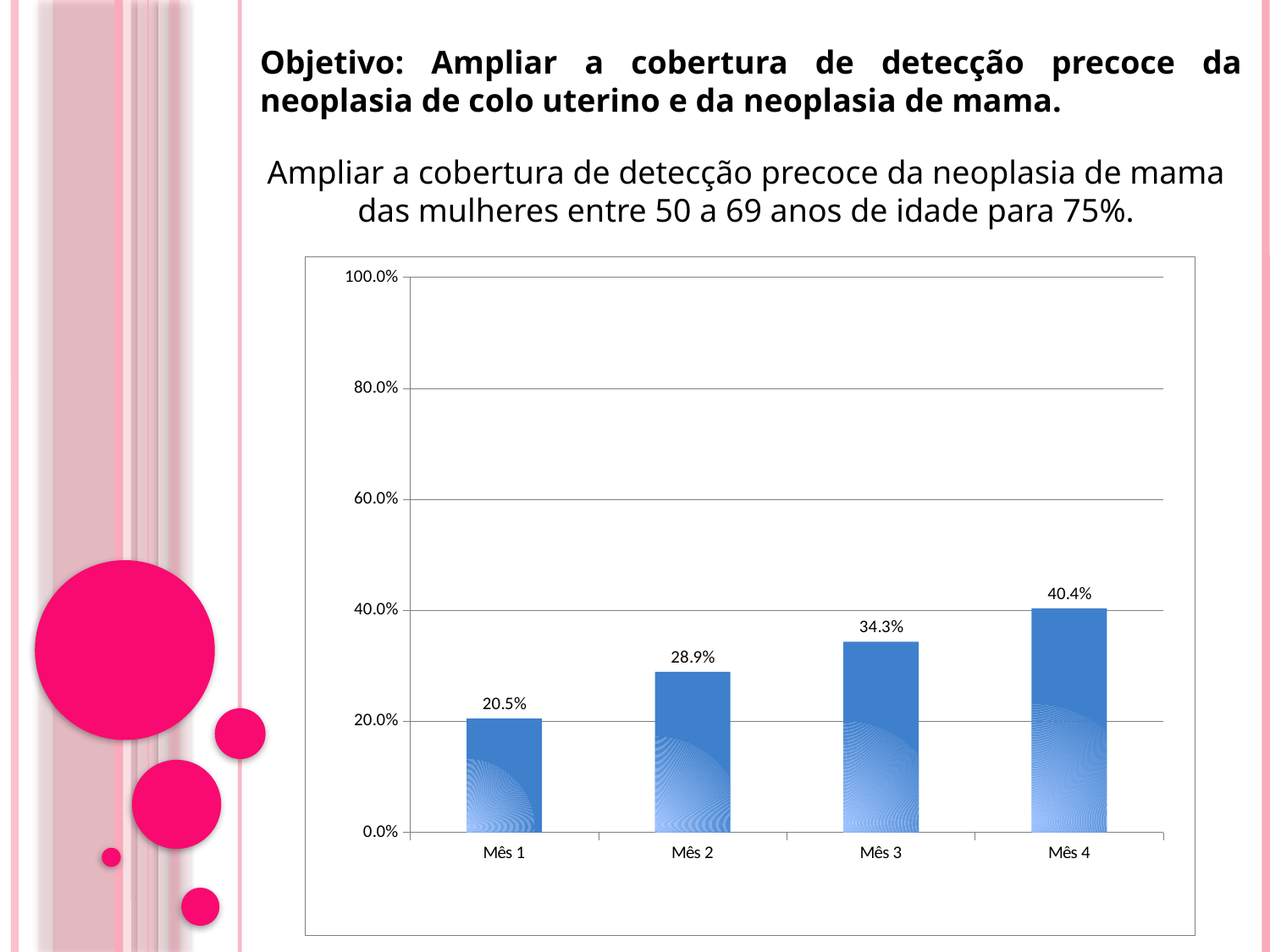
Which month has the lowest value? Mês 1 Which is larger, the value for Mês 2 or the value for Mês 3? Mês 3 Do the values rise or fall from Mês 1 to Mês 4? rise What is the difference between the values for Mês 2 and Mês 1? 8.4% What kind of chart is shown on the slide? bar chart Which month has the highest value? Mês 4 How many months are shown on the x axis? 4 What is the value for Mês 4? 40.4% What is the value for Mês 3? 34.3% Is the value for Mês 4 greater or less than 60.0%? less What is the value for Mês 1? 20.5% What is the difference between the values for Mês 4 and Mês 1? 19.9%